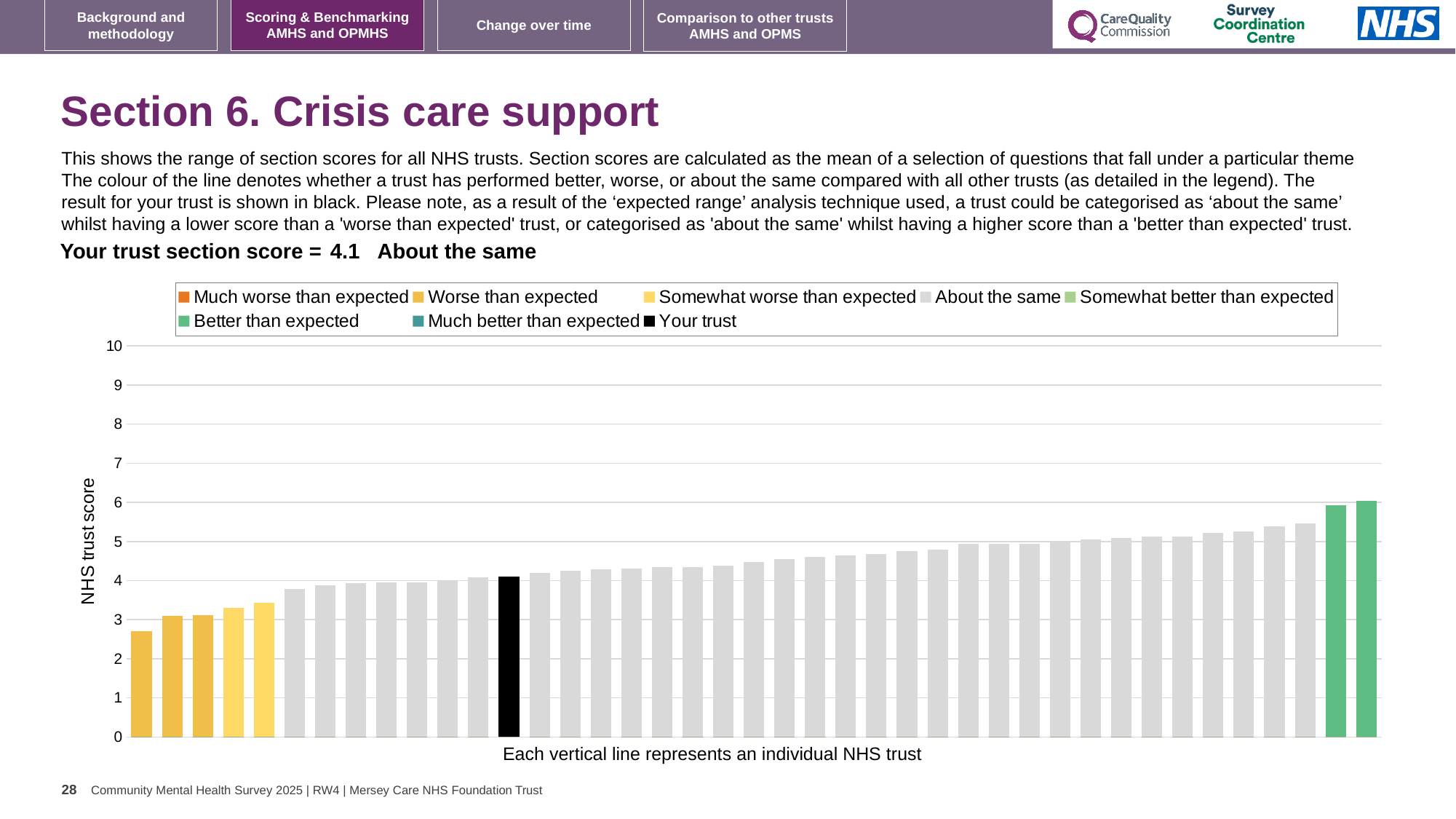
What is the label on the vertical axis of the chart? NHS trust score What is the section score for your trust shown on the slide? 4.1 Do the bar values rise or fall moving from left to right along the x axis? rise How many entries does the chart legend list? 8 Is the value of the highest bar (rightmost trust) greater or less than 5? greater Is the value for your trust (the black bar) greater or less than 4? greater What kind of chart is shown on the slide? bar chart How many trusts are shown in the 'Better than expected' (green) category? 2 Is the value of the lowest bar (leftmost trust) greater or less than 3? less Which legend category does the highest-scoring trust belong to? Better than expected What colour is the bar representing your trust? black Which legend category does the lowest-scoring trust belong to? Worse than expected